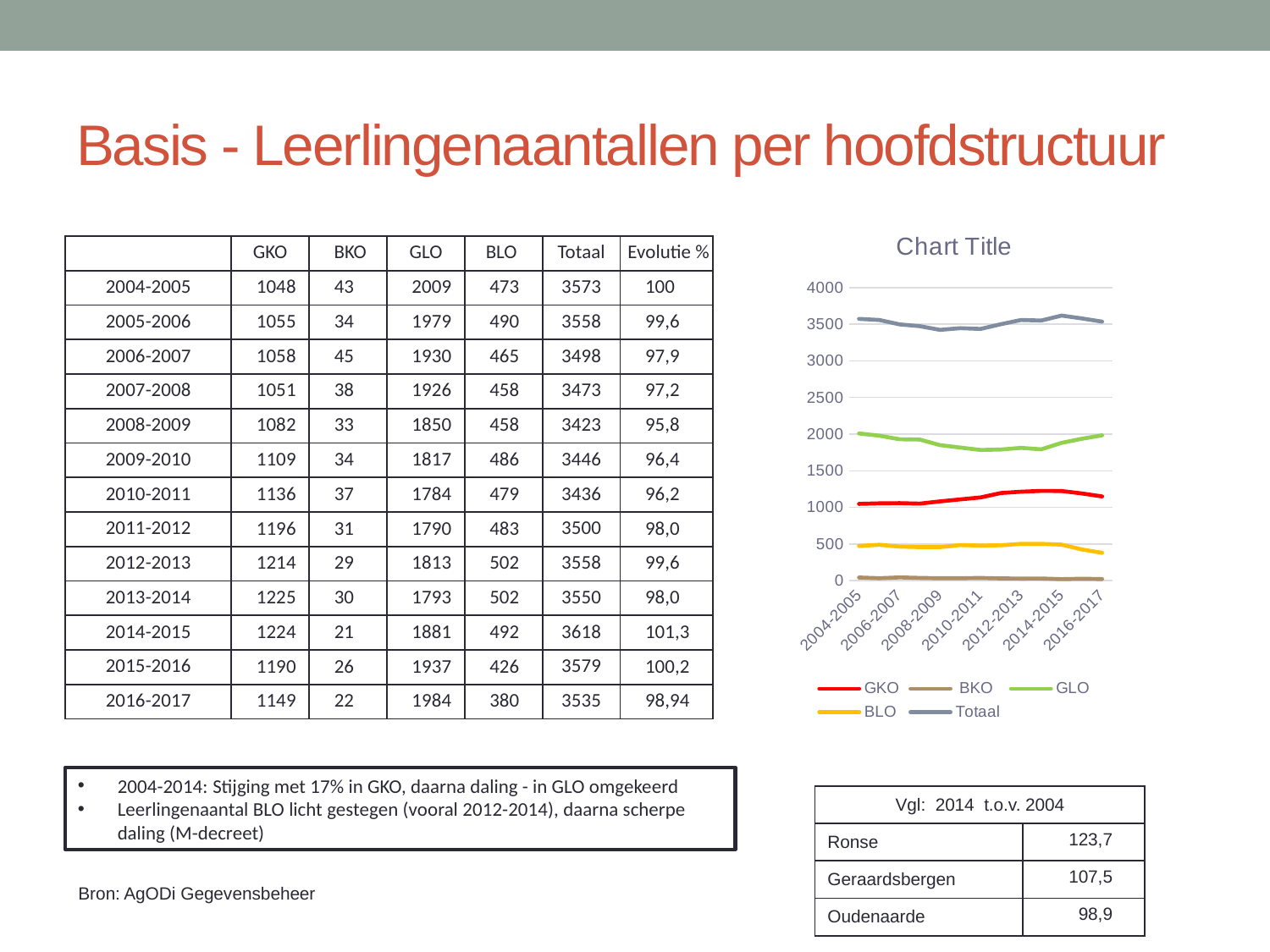
Which series has the highest values across the whole chart? Totaal Is the value of the BLO line for 2016-2017 greater or less than 500? less Does the GKO line rise or fall from 2004-2005 to 2013-2014? rise How many series does the chart legend list? 5 What kind of chart is shown on the slide? line chart Is the value of the GKO line for 2016-2017 greater or less than 1000? greater What is the title shown above the chart? Chart Title In 2004-2005, which series has the larger value, GLO or GKO? GLO Is the value of the Totaal line for 2004-2005 greater or less than 3000? greater Which series has the lowest values across the whole chart? BKO